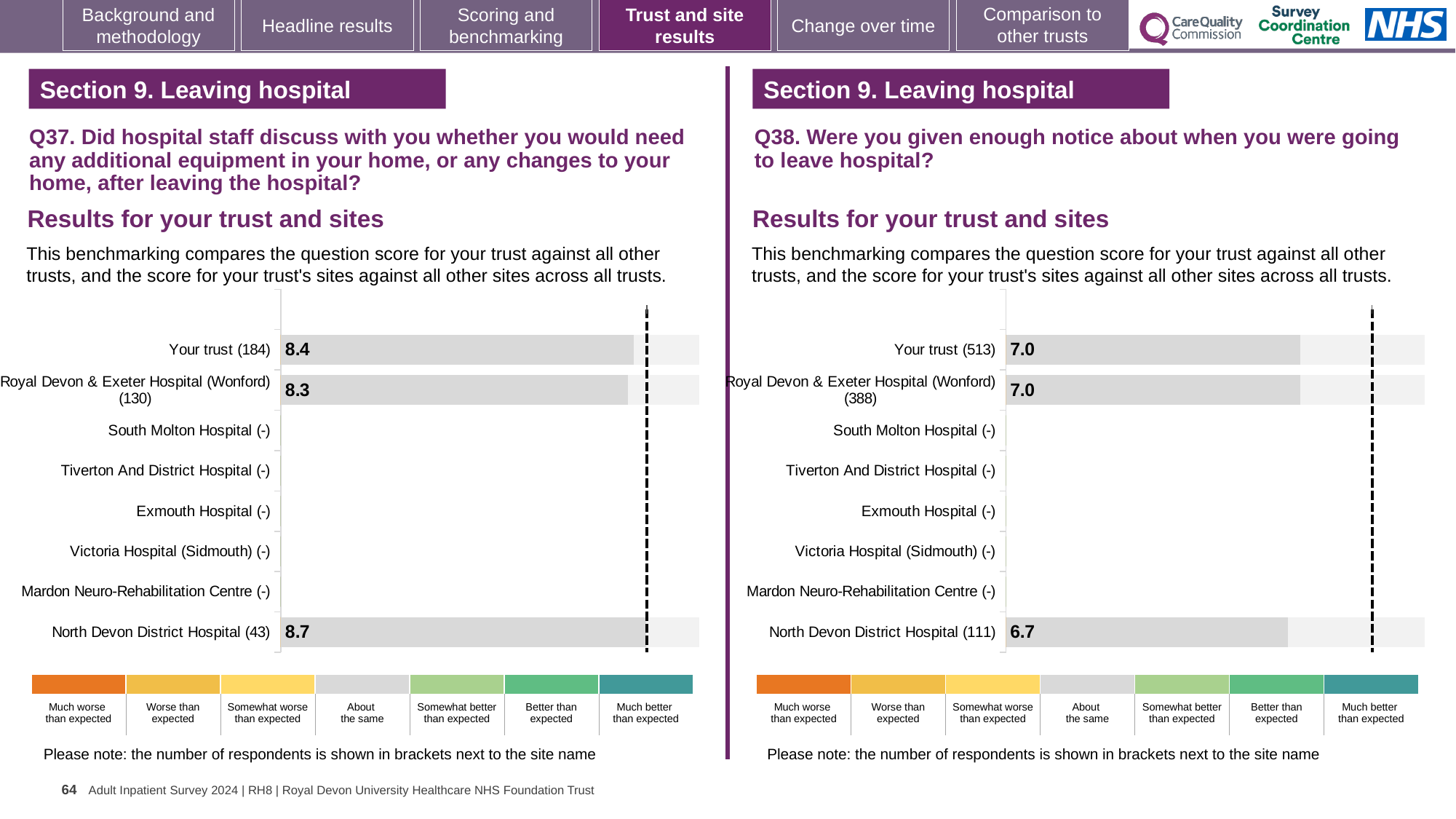
On the Q37 chart, what is the score for North Devon District Hospital? 8.7 How many site rows (including Your trust) are listed on the Q37 chart? 8 On the Q37 chart, which site has the highest score? North Devon District Hospital On the Q38 chart, how many respondents are shown in brackets for Your trust? 513 What kind of chart is used on the Q38 side of the slide? Bar chart On the Q37 chart, what is the score for Your trust? 8.4 On the Q38 chart, what is the score for Your trust? 7.0 On the Q37 chart, what is the score for Royal Devon & Exeter Hospital (Wonford)? 8.3 On the Q38 chart, which is larger, the score for Royal Devon & Exeter Hospital (Wonford) or the score for North Devon District Hospital? Royal Devon & Exeter Hospital (Wonford) On the Q38 chart, what is the score for North Devon District Hospital? 6.7 On the Q37 chart, what is the difference between the scores for North Devon District Hospital and Royal Devon & Exeter Hospital (Wonford)? 0.4 On the Q38 chart, what is the difference between the scores for Your trust and North Devon District Hospital? 0.3